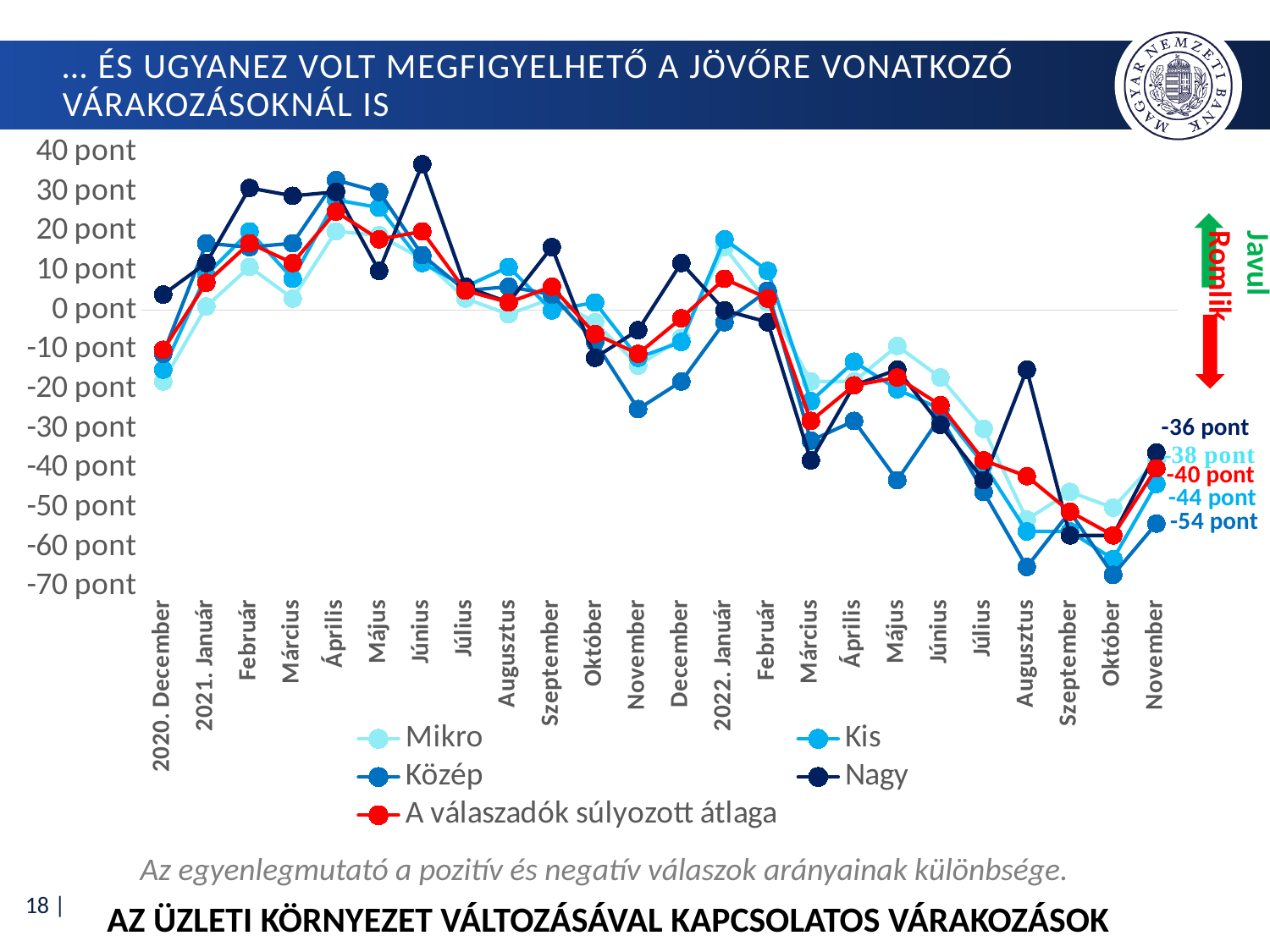
Overall, do the values rise or fall from 2021 to late 2022? fall What type of chart is shown on the slide? line chart What is the difference between the Nagy and Közép values in November 2022? 18 pont How many monthly data points are plotted along the x axis? 24 What is the value for Nagy in November 2022? -36 pont Is the value for Közép in October 2022 greater or less than -60 pont? less What is the value for Közép in November 2022? -54 pont What is the value of A válaszadók súlyozott átlaga in November 2022? -40 pont How many series does the legend list? 5 Which series has the lowest value in November 2022? Közép Is the value for Nagy in June 2021 greater or less than 30 pont? greater In November 2022, which is higher: Mikro or Kis? Mikro